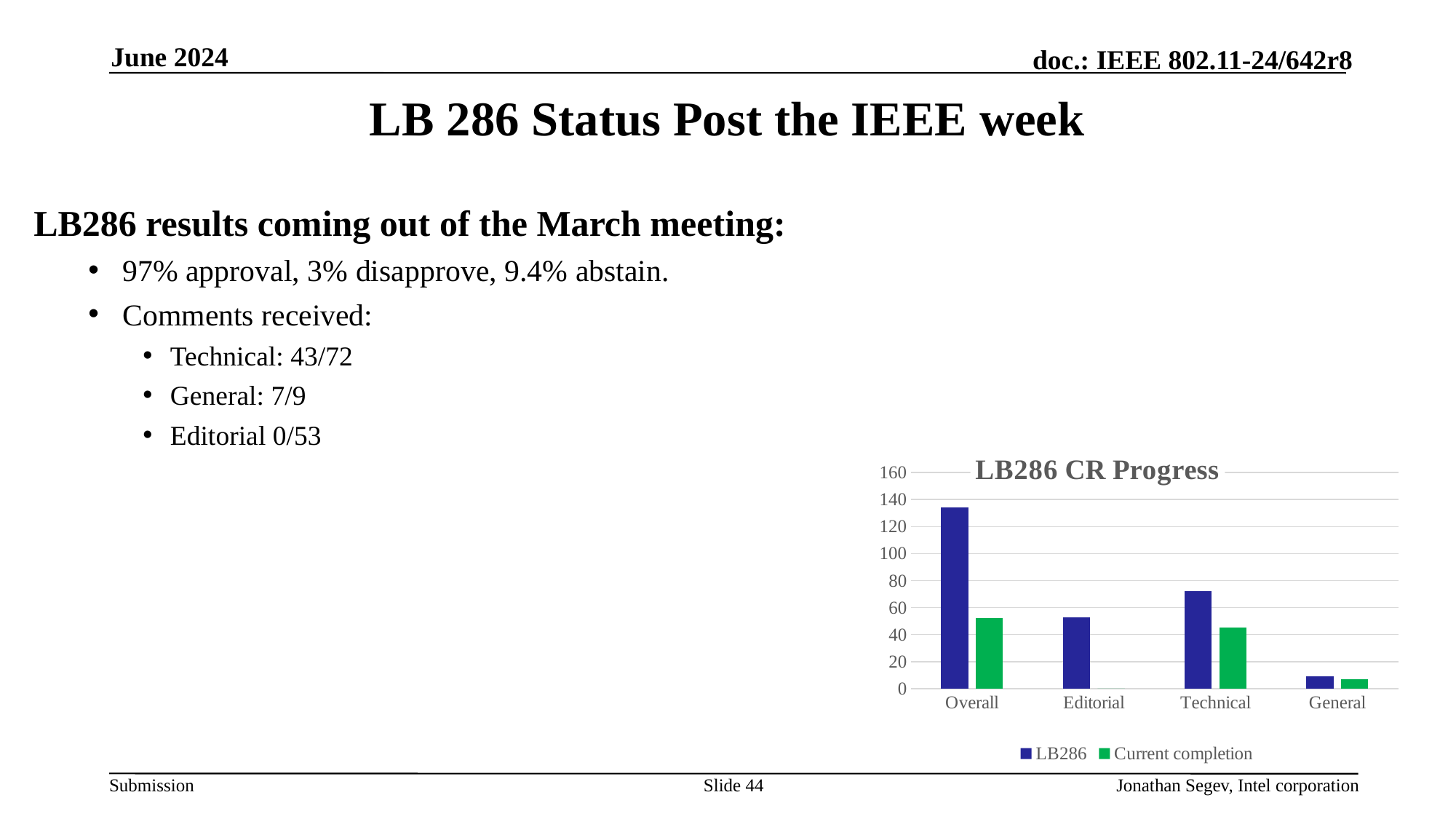
Is the LB286 value for Overall greater or less than 120? greater Which series is shown in green in the chart? Current completion Which category has the lowest LB286 value? General Is the Current completion value for Overall greater or less than 60? less What is the title of the chart? LB286 CR Progress How many categories are shown on the x axis of the chart? 4 Is the LB286 value for General greater or less than 20? less Which category has the highest LB286 value? Overall How many series does the chart legend list? 2 Which is larger, the LB286 value for Technical or the LB286 value for Editorial? Technical What type of chart is shown on the slide? bar chart